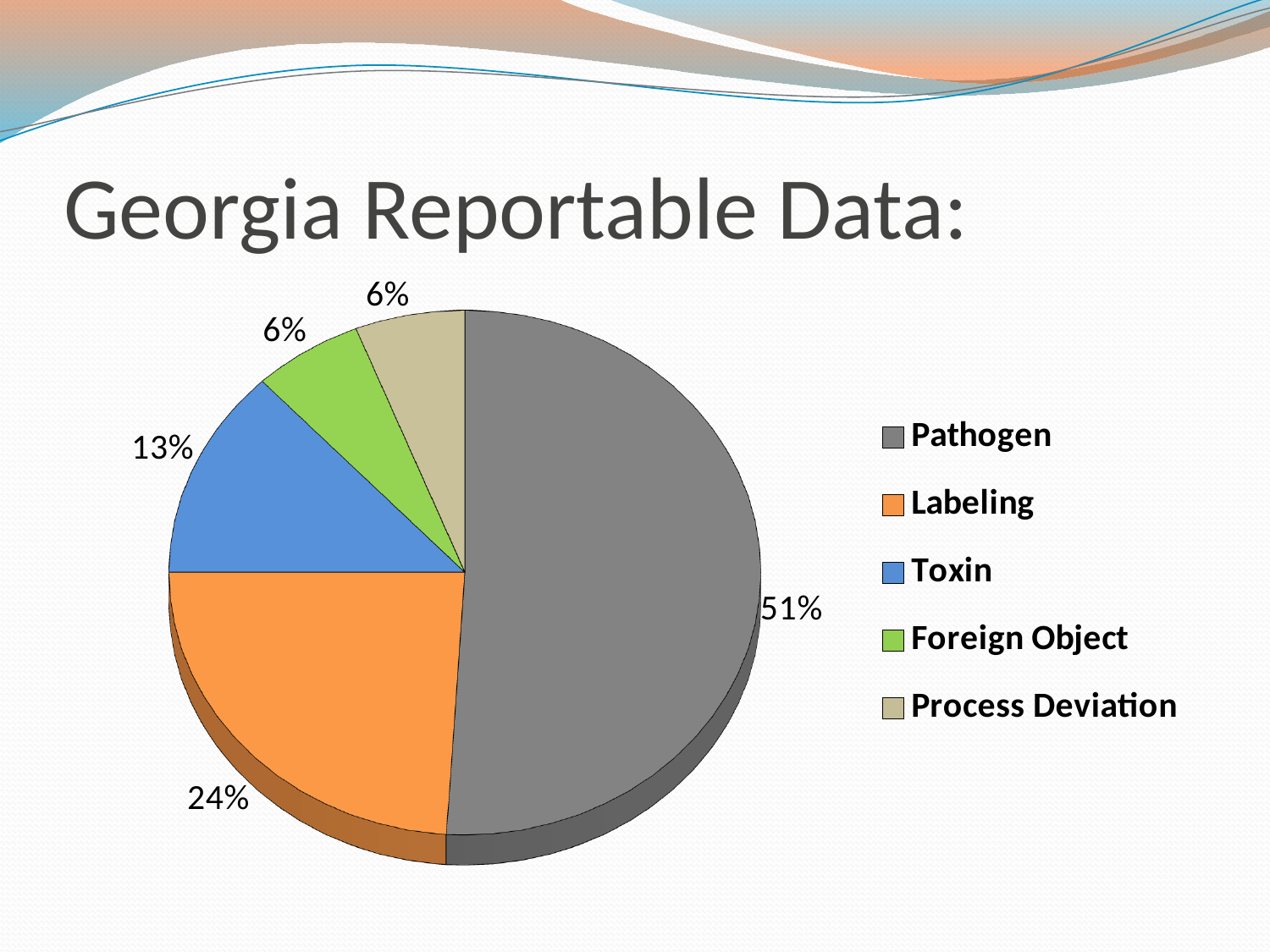
What kind of chart is shown on the slide? Pie chart What share of the pie does Toxin represent? 13% Which category has the largest slice of the pie? Pathogen What share of the pie does Pathogen represent? 51% What is the difference in percentage points between Labeling and Toxin? 11 What colour is the Toxin slice in the pie chart? Blue What is the difference in percentage points between Pathogen and Labeling? 27 What share of the pie does Foreign Object represent? 6% Which is larger, the share for Toxin or the share for Labeling? Labeling How many categories does the pie chart show? 5